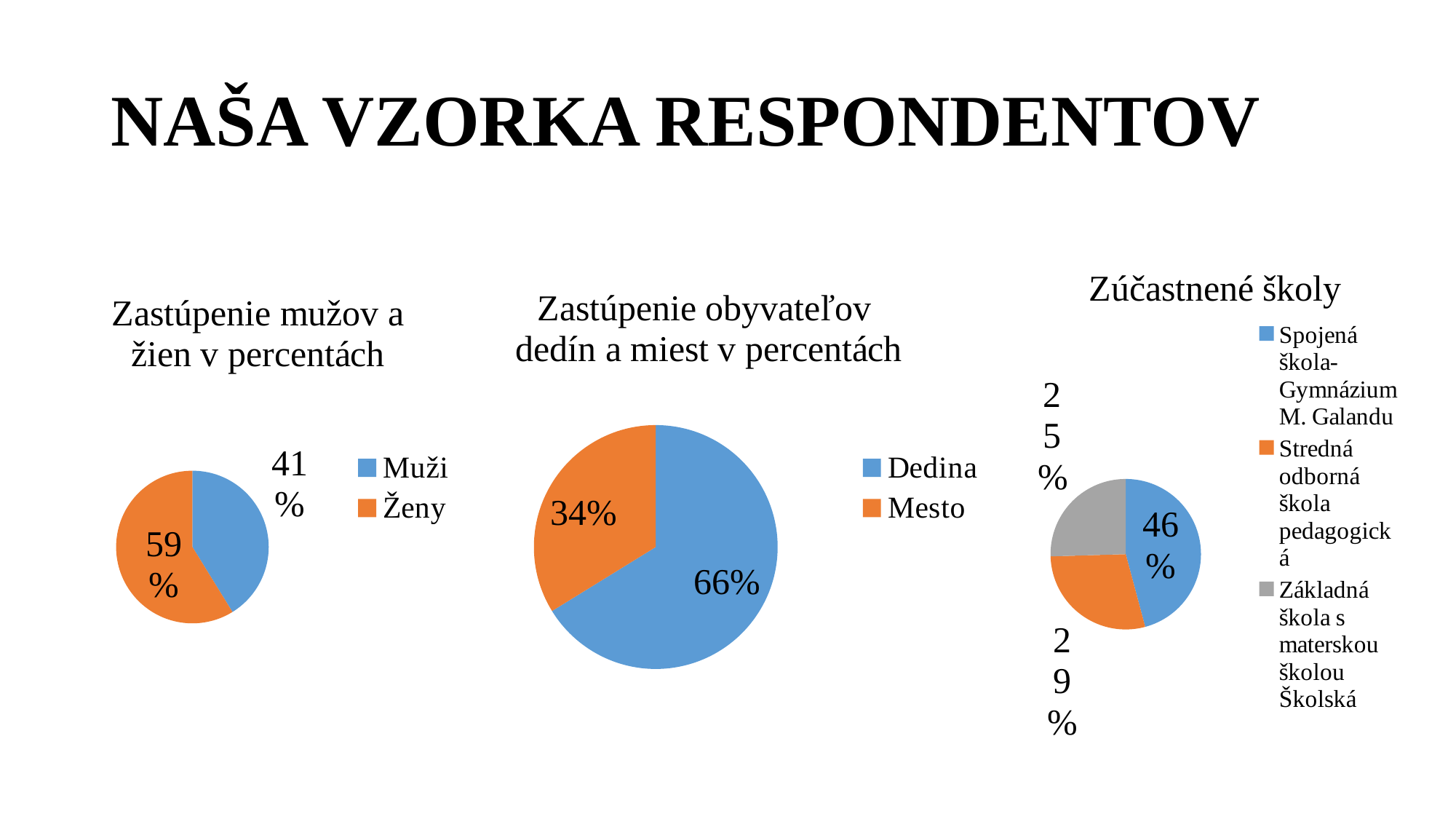
In the chart titled "Zastúpenie mužov a žien v percentách", what is the difference between the Ženy and Muži shares? 18% In the chart titled "Zastúpenie obyvateľov dedín a miest v percentách", what is the value for Dedina? 66% In the chart titled "Zúčastnené školy", what is the share for Spojená škola-Gymnázium M. Galandu? 46% In the chart titled "Zastúpenie mužov a žien v percentách", what is the value for Muži? 41% How many categories does the legend of the chart titled "Zúčastnené školy" list? 3 In the chart titled "Zastúpenie obyvateľov dedín a miest v percentách", what is the value for Mesto? 34% In the chart titled "Zastúpenie obyvateľov dedín a miest v percentách", which is larger, Dedina or Mesto? Dedina In the chart titled "Zúčastnené školy", what is the share for Stredná odborná škola pedagogická? 29% In the chart titled "Zúčastnené školy", which school has the smallest share? Základná škola s materskou školou Školská In the chart titled "Zastúpenie mužov a žien v percentách", what is the value for Ženy? 59% What kind of chart is the chart titled "Zastúpenie obyvateľov dedín a miest v percentách"? Pie chart In the chart titled "Zastúpenie mužov a žien v percentách", which category has the larger share? Ženy